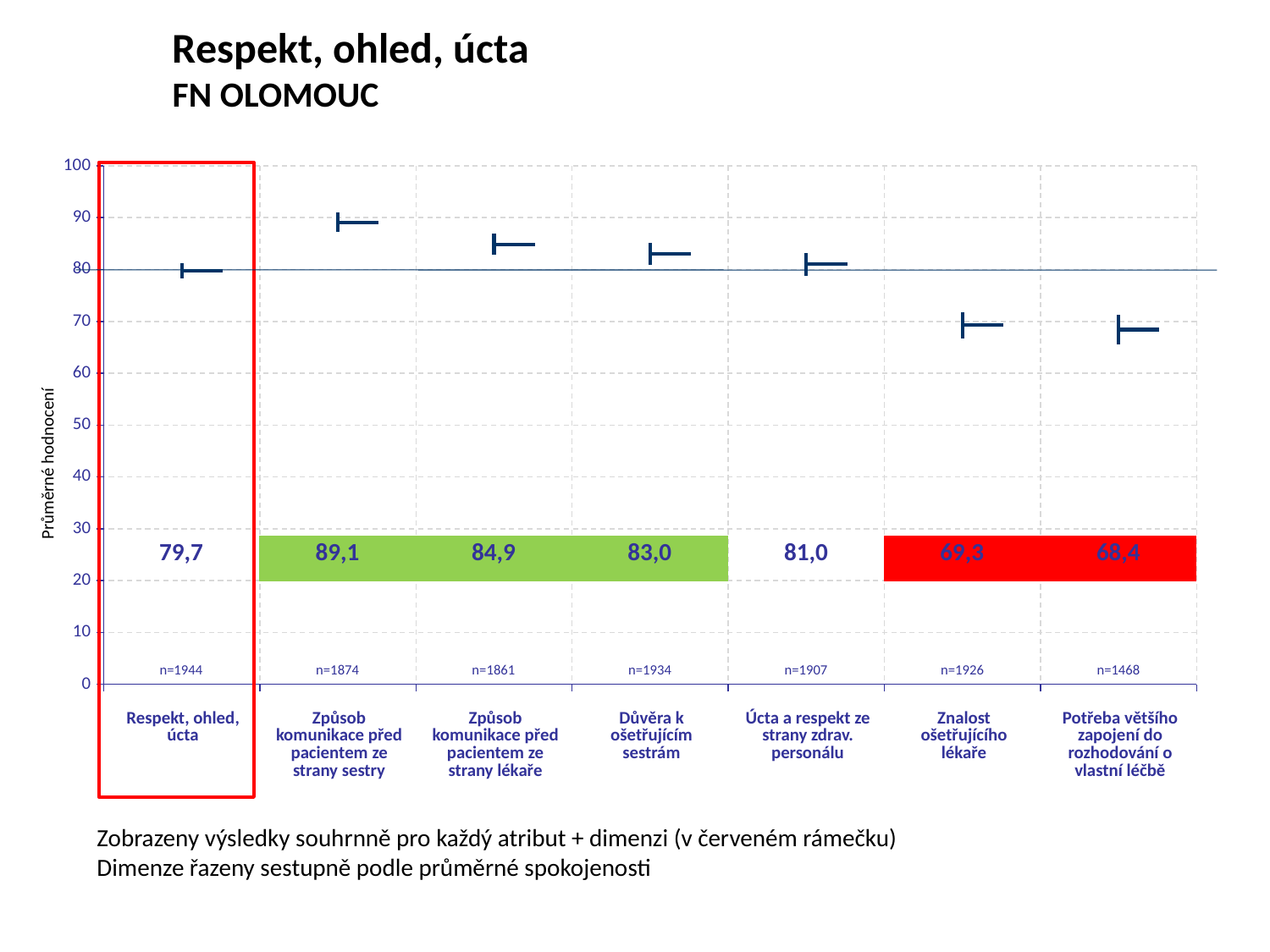
Which is larger, the value for "Důvěra k ošetřujícím sestrám" or the value for "Úcta a respekt ze strany zdrav. personálu"? Důvěra k ošetřujícím sestrám Is the value for "Znalost ošetřujícího lékaře" greater or less than 80? less What is the difference between the values for "Způsob komunikace před pacientem ze strany sestry" and "Potřeba většího zapojení do rozhodování o vlastní léčbě"? 20,7 Which category has the highest value? Způsob komunikace před pacientem ze strany sestry Which category has the lowest value? Potřeba většího zapojení do rozhodování o vlastní léčbě Which category is enclosed in the red frame? Respekt, ohled, úcta What is the value for "Znalost ošetřujícího lékaře"? 69,3 What is the value for "Způsob komunikace před pacientem ze strany sestry"? 89,1 How many categories are shown on the x axis? 7 What is the label of the y axis? Průměrné hodnocení What is the sample size (n) shown for "Důvěra k ošetřujícím sestrám"? n=1934 What is the value for "Respekt, ohled, úcta"? 79,7